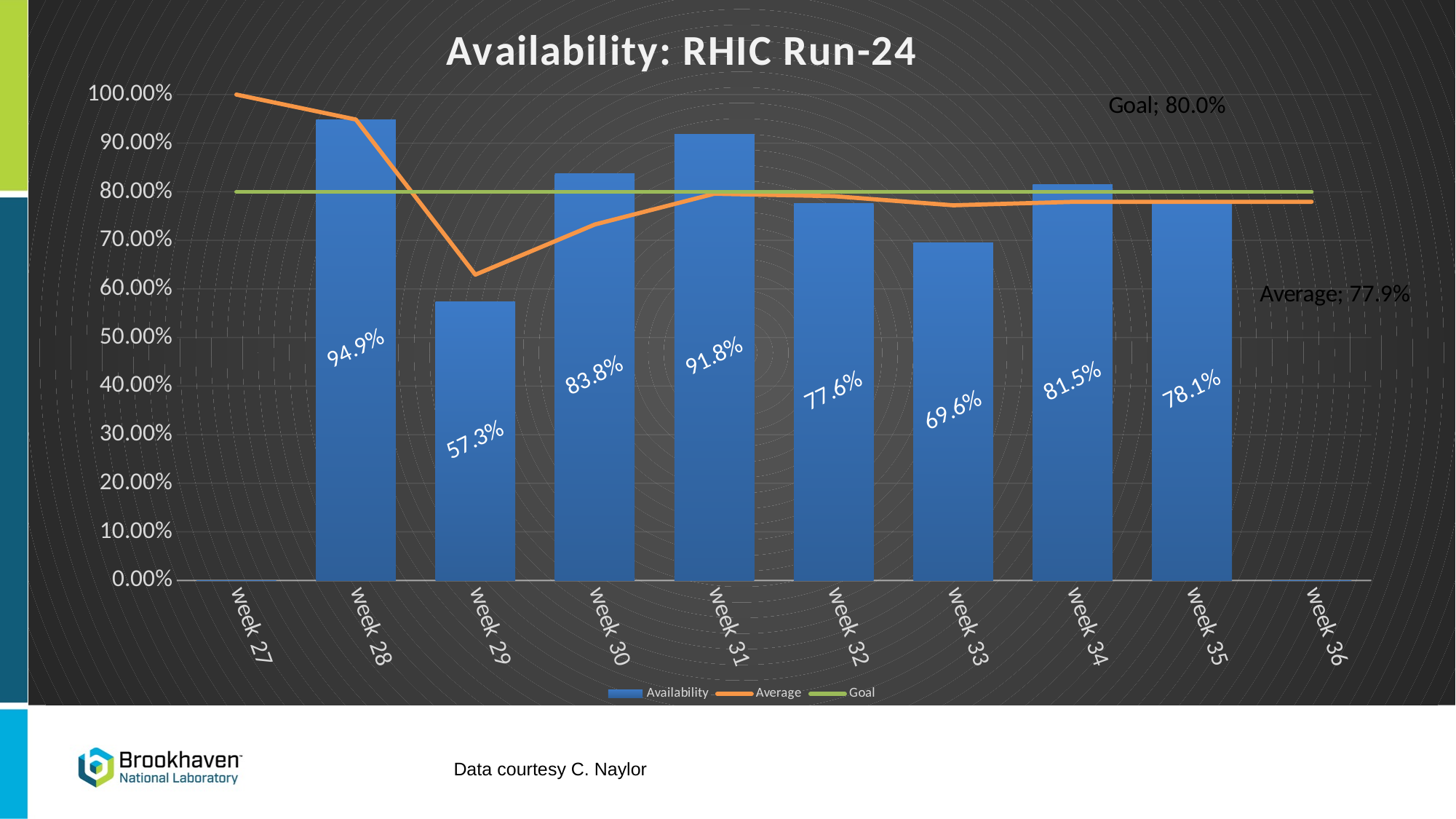
Is the availability for week 35 greater or less than 80.00%? less What kind of chart is used to show the weekly availability values? bar chart What is the title of the chart? Availability: RHIC Run-24 Which week has the lowest availability? week 29 Which week has the highest availability? week 28 What is the availability for week 33? 69.6% How many series does the legend list? 3 What is the difference in availability between week 31 and week 32? 14.2% What is the availability for week 28? 94.9% What is the value of the Goal line? 80.0% Which has the higher availability, week 30 or week 34? week 30 How many weeks have an availability bar plotted? 8